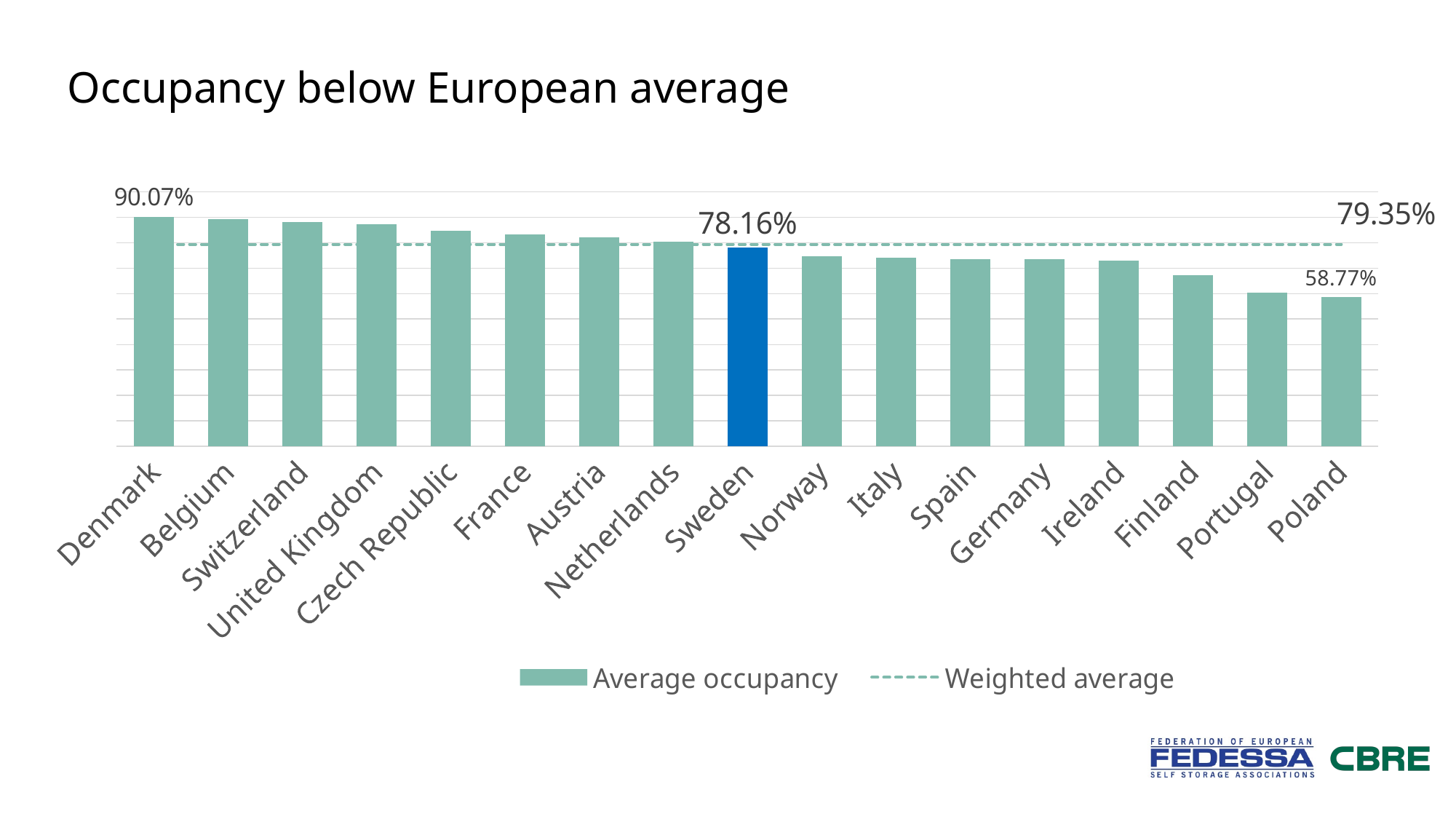
What is the average occupancy value shown for Poland? 58.77% Which is larger, the average occupancy for Sweden or for Norway? Sweden What is the difference between Denmark's and Poland's average occupancy? 31.30% By how much is Sweden's average occupancy below the weighted average? 1.19% How many entries does the legend list? 2 How many countries are shown on the chart? 17 What kind of chart is shown on the slide? Bar chart Which country has the highest average occupancy? Denmark Which country has the lowest average occupancy? Poland What is the average occupancy value shown for Sweden? 78.16% What is the average occupancy value shown for Denmark? 90.07% What is the weighted average value shown by the dashed line? 79.35%